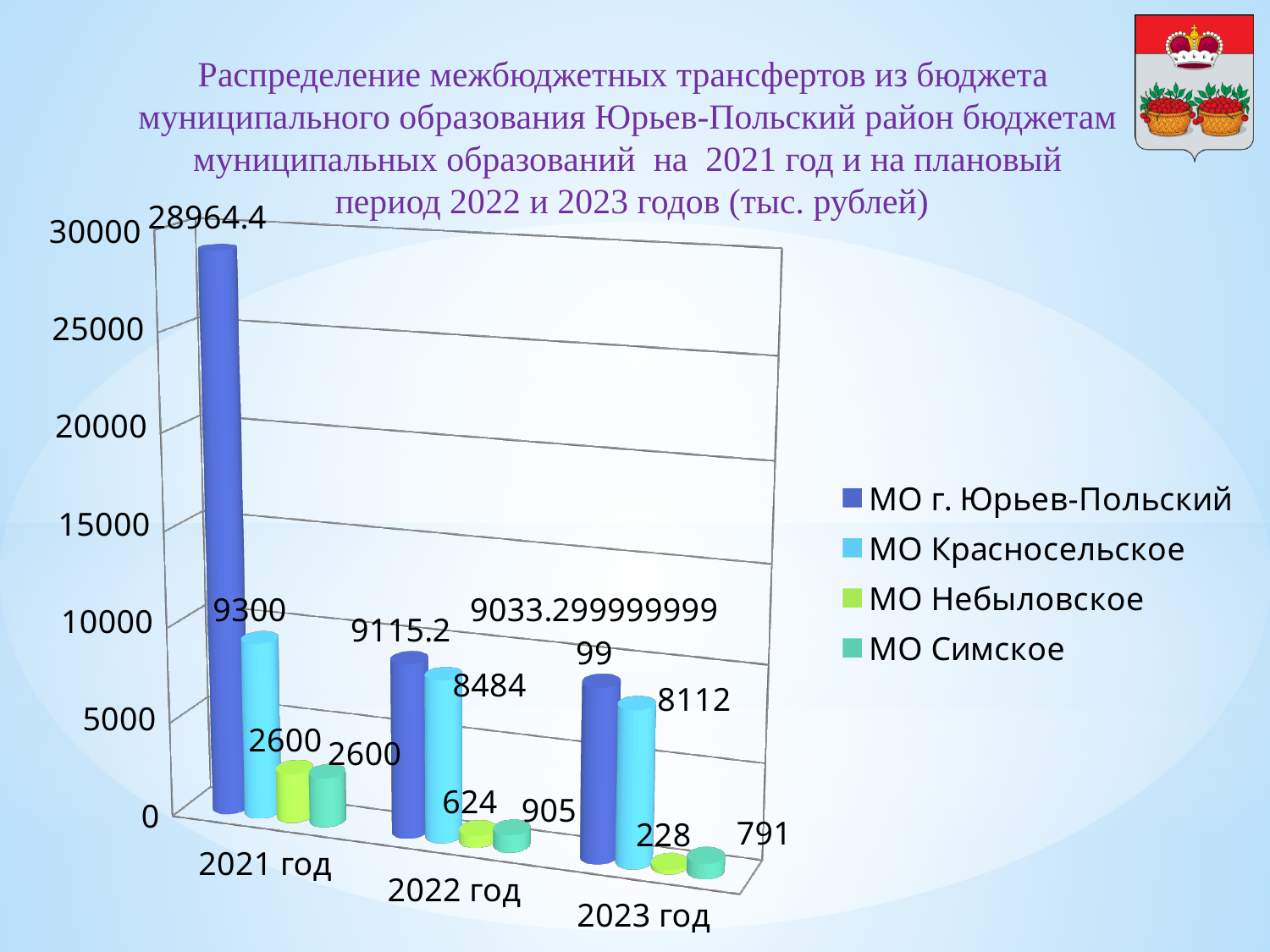
Which is larger: МО Симское in 2022 год or МО Симское in 2023 год? МО Симское in 2022 год How does the value for МО Красносельское change from 2021 год to 2023 год? It falls Which series has the highest value in 2021 год? МО г. Юрьев-Польский What is the value for МО Симское in 2022 год? 905 What is the value for МО Небыловское in 2023 год? 228 What is the difference between the МО Красносельское values for 2021 год and 2023 год? 1188 What is the value for МО Красносельское in 2022 год? 8484 How many series does the legend list? 4 What is the value for МО г. Юрьев-Польский in 2021 год? 28964.4 Which series has the lowest value in 2023 год? МО Небыловское What kind of chart is shown on the slide? Bar chart What is the difference between the МО Небыловское values for 2021 год and 2022 год? 1976